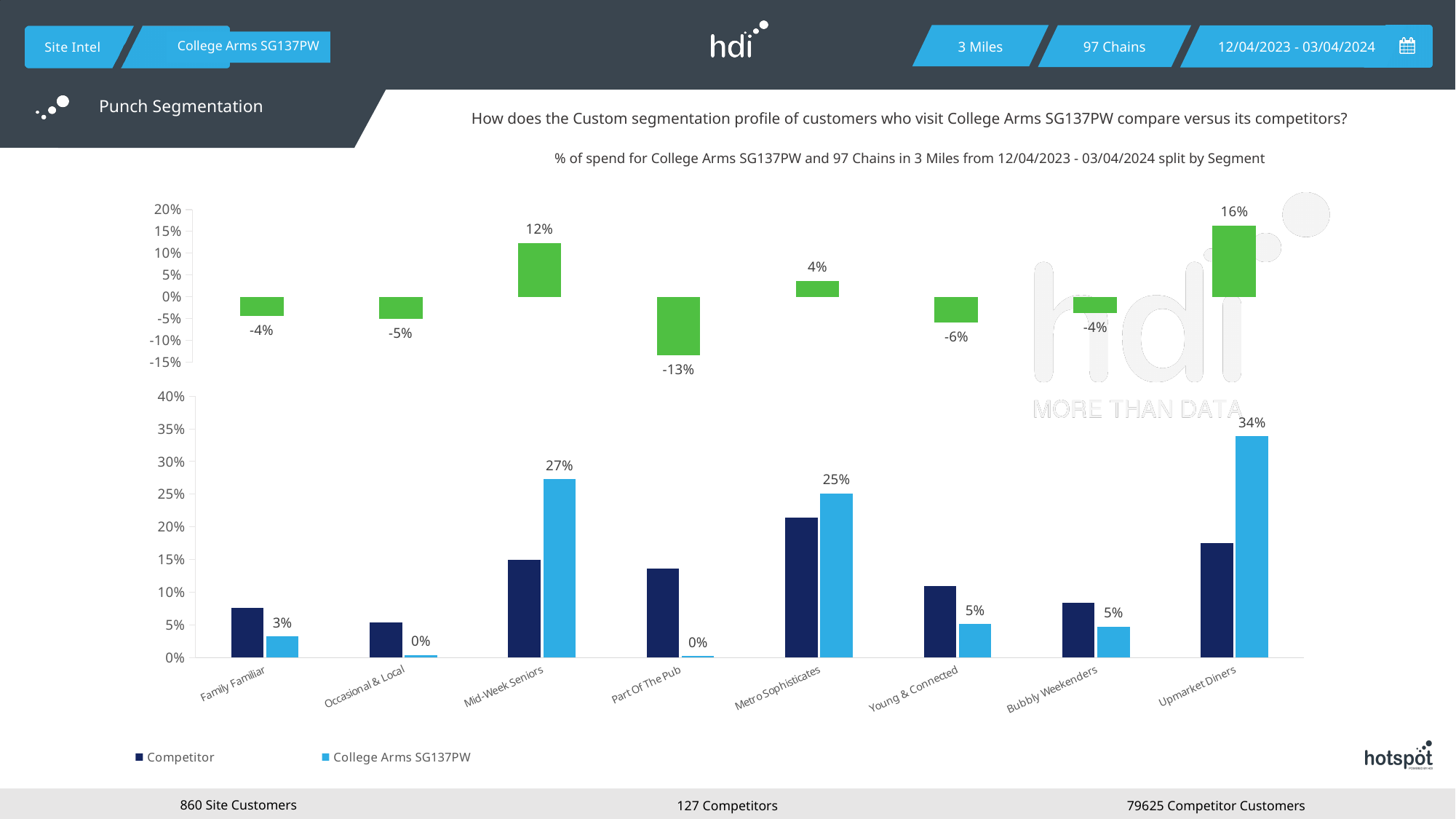
How many segments are shown on the x axis of the bottom chart? 8 In the bottom chart, what is the value for College Arms SG137PW in the Upmarket Diners segment? 34% In the bottom chart, which segment has the lowest College Arms SG137PW value? Occasional & Local and Part Of The Pub (both 0%) In the bottom chart, which is larger for Young & Connected: the Competitor value or the College Arms SG137PW value? Competitor In the bottom chart, is the Competitor value for Metro Sophisticates greater or less than 20%? greater In the bottom chart, what is the difference between the College Arms SG137PW values for Upmarket Diners and Metro Sophisticates? 9% In the top chart, what is the value shown for Part Of The Pub? -13% In the bottom chart, what is the value for College Arms SG137PW in the Mid-Week Seniors segment? 27% How many series does the legend of the bottom chart list? 2 In the top chart, which segment has the lowest value? Part Of The Pub In the bottom chart, is the Competitor value for Family Familiar greater or less than 10%? less In the top chart, which segment has the highest value? Upmarket Diners